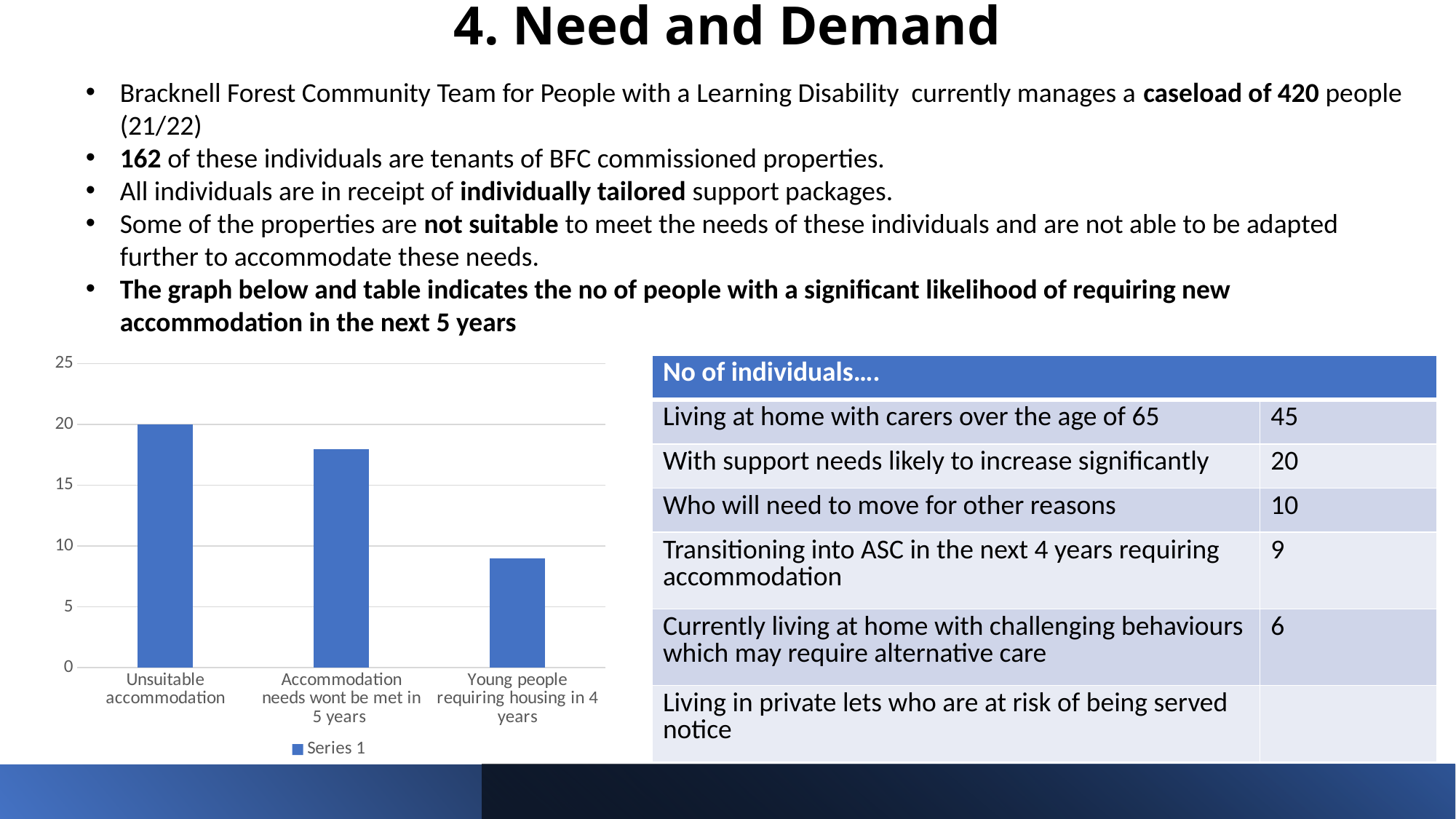
Is the value for Accommodation needs wont be met in 5 years greater or less than 15? greater Do the bar values rise or fall from left to right across the chart? fall Is the value for Young people requiring housing in 4 years greater or less than 10? less How many series does the chart legend list? 1 Which category has the lowest bar in the chart? Young people requiring housing in 4 years What is the name of the series shown in the chart legend? Series 1 Which is larger in the chart: Unsuitable accommodation or Accommodation needs wont be met in 5 years? Unsuitable accommodation What is the value for Unsuitable accommodation in the chart? 20 What kind of chart is shown on the slide? bar chart Which category has the highest bar in the chart? Unsuitable accommodation Which is larger in the chart: Accommodation needs wont be met in 5 years or Young people requiring housing in 4 years? Accommodation needs wont be met in 5 years How many categories are plotted on the bar chart? 3